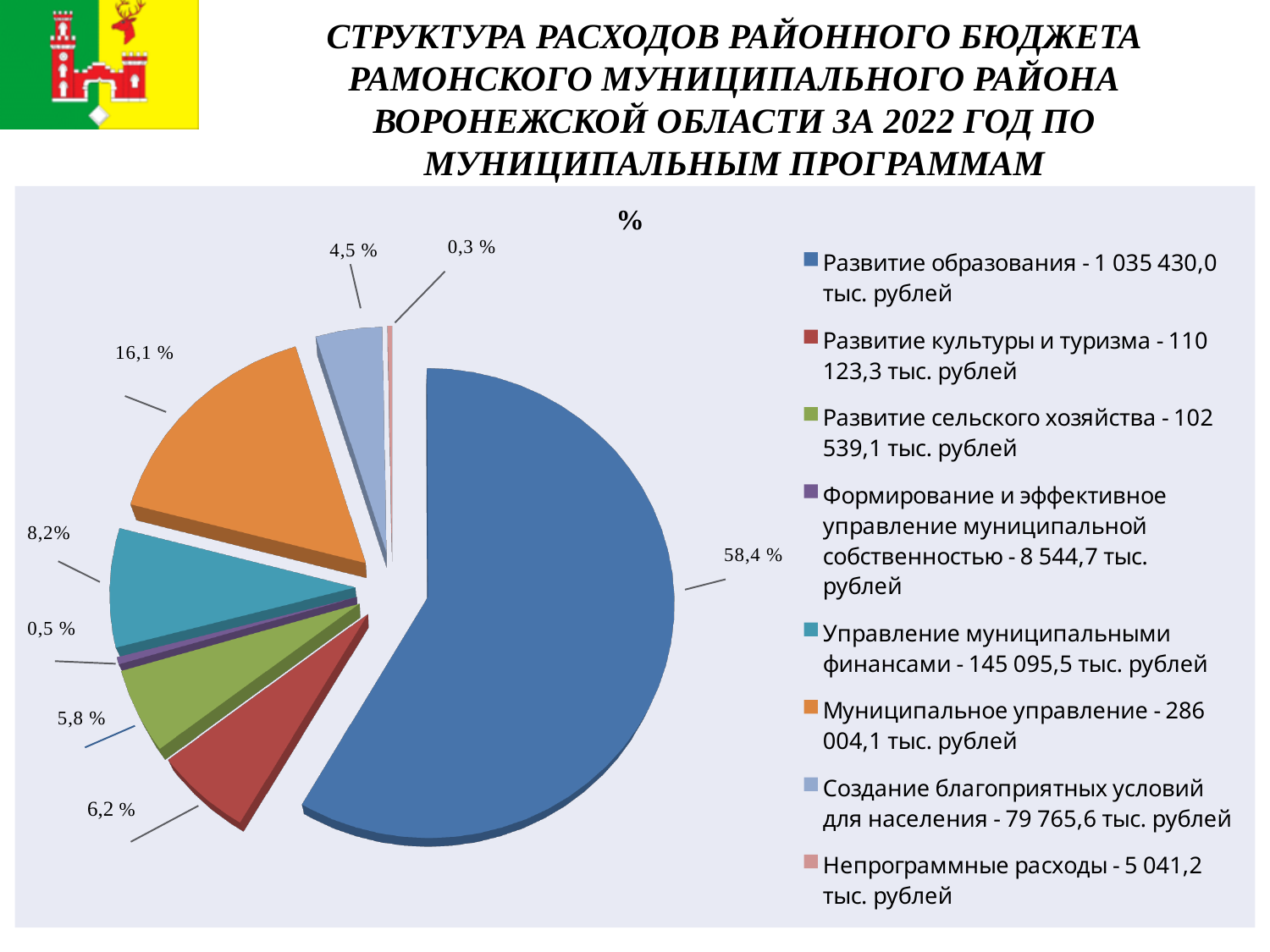
What share of the pie does the slice for Непрограммные расходы have? 0,3 % What type of chart is shown on the slide? pie chart Which category has the largest slice of the pie? Развитие образования What share of the pie does the slice for Муниципальное управление have? 16,1 % Which slice is larger: Развитие культуры и туризма or Создание благоприятных условий для населения? Развитие культуры и туризма What share of the pie does the slice for Управление муниципальными финансами have? 8,2% How many entries does the legend of the pie chart list? 8 What is the title shown above the pie chart? % Which category has the smallest slice of the pie? Непрограммные расходы How many slices does the pie chart have? 8 What amount in thousand rubles does the legend give for Управление муниципальными финансами? 145 095,5 тыс. рублей